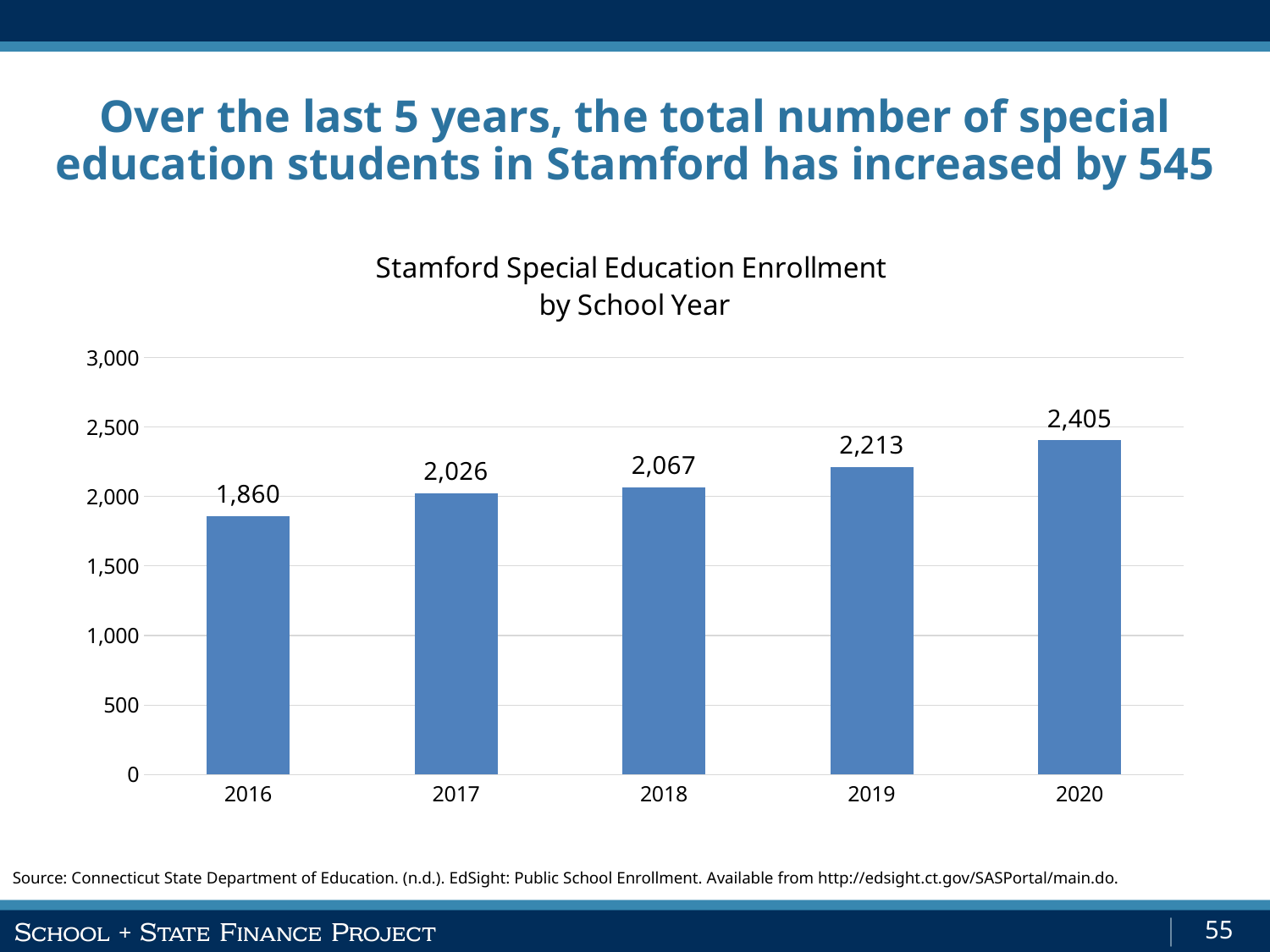
How many school years are shown in the chart? 5 Which school year has the highest special education enrollment? 2020 What is the difference in enrollment between 2020 and 2016? 545 What is the difference in enrollment between 2019 and 2018? 146 Which school year has the lowest special education enrollment? 2016 Which year has higher enrollment, 2017 or 2019? 2019 What is the special education enrollment for 2018? 2,067 What is the special education enrollment for 2016? 1,860 Is the value for 2016 greater or less than 2,000? less Do the enrollment values rise or fall from 2016 to 2020? rise What kind of chart is shown on the slide? bar chart What is the special education enrollment for 2020? 2,405